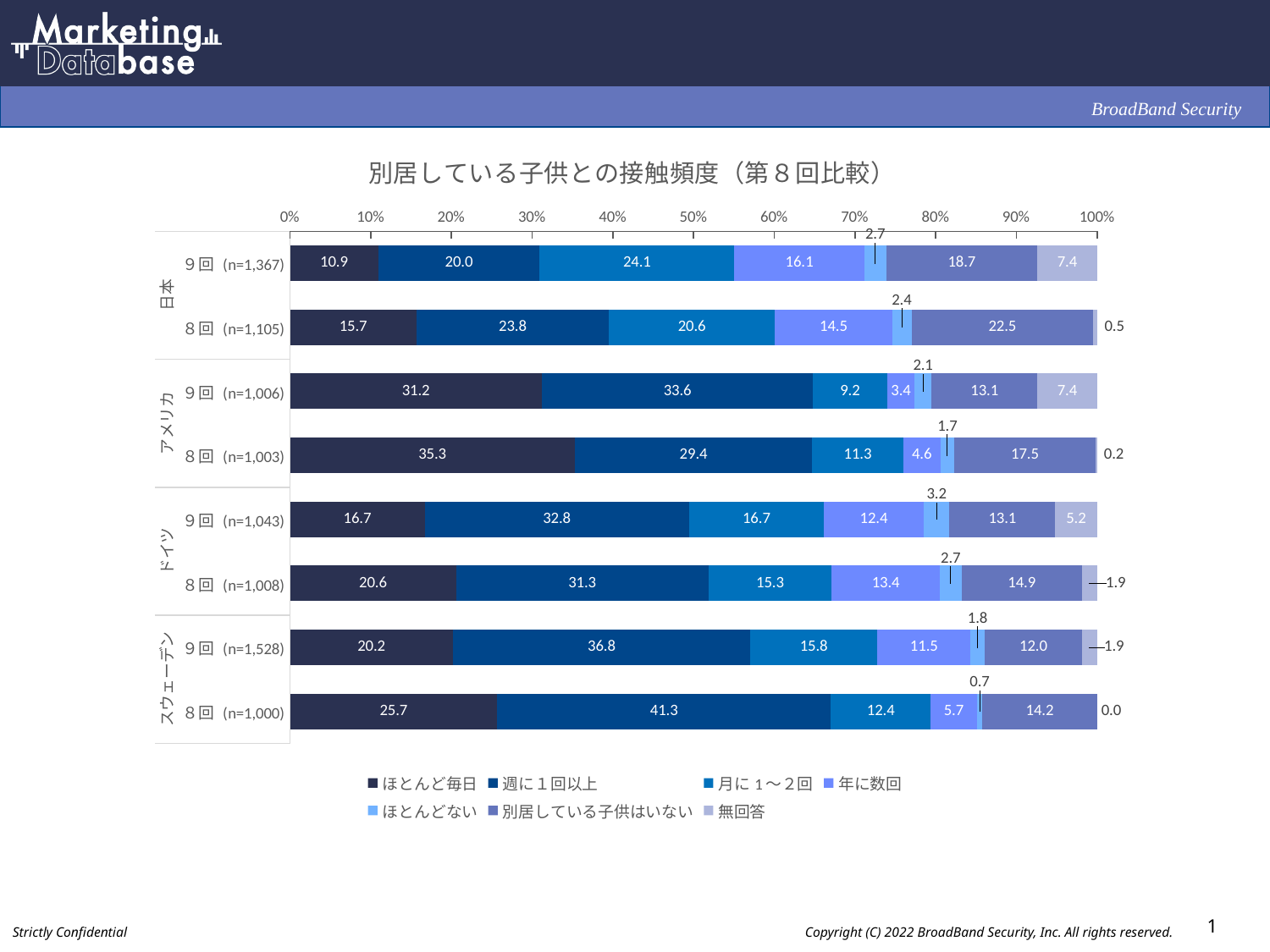
What is the difference between the 週に１回以上 values for スウェーデン 8回 (n=1,000) and スウェーデン 9回 (n=1,528)? 4.5 Which bar has the lowest value for ほとんど毎日? 日本 9回 (n=1,367) What is the value of ほとんど毎日 for 日本 9回 (n=1,367)? 10.9 What is the title of the chart? 別居している子供との接触頻度（第８回比較） What is the value of 週に１回以上 for スウェーデン 8回 (n=1,000)? 41.3 Which bar has the highest value for ほとんど毎日? アメリカ 8回 (n=1,003) Which is larger, the 月に１～２回 value for 日本 9回 (n=1,367) or for 日本 8回 (n=1,105)? 日本 9回 (n=1,367) What is the value of ほとんどない for ドイツ 9回 (n=1,043)? 3.2 How many bars (survey rounds) are plotted in the chart? 8 What type of chart is shown on the slide? Stacked bar chart What is the value of 別居している子供はいない for アメリカ 8回 (n=1,003)? 17.5 How many series does the legend list? 7